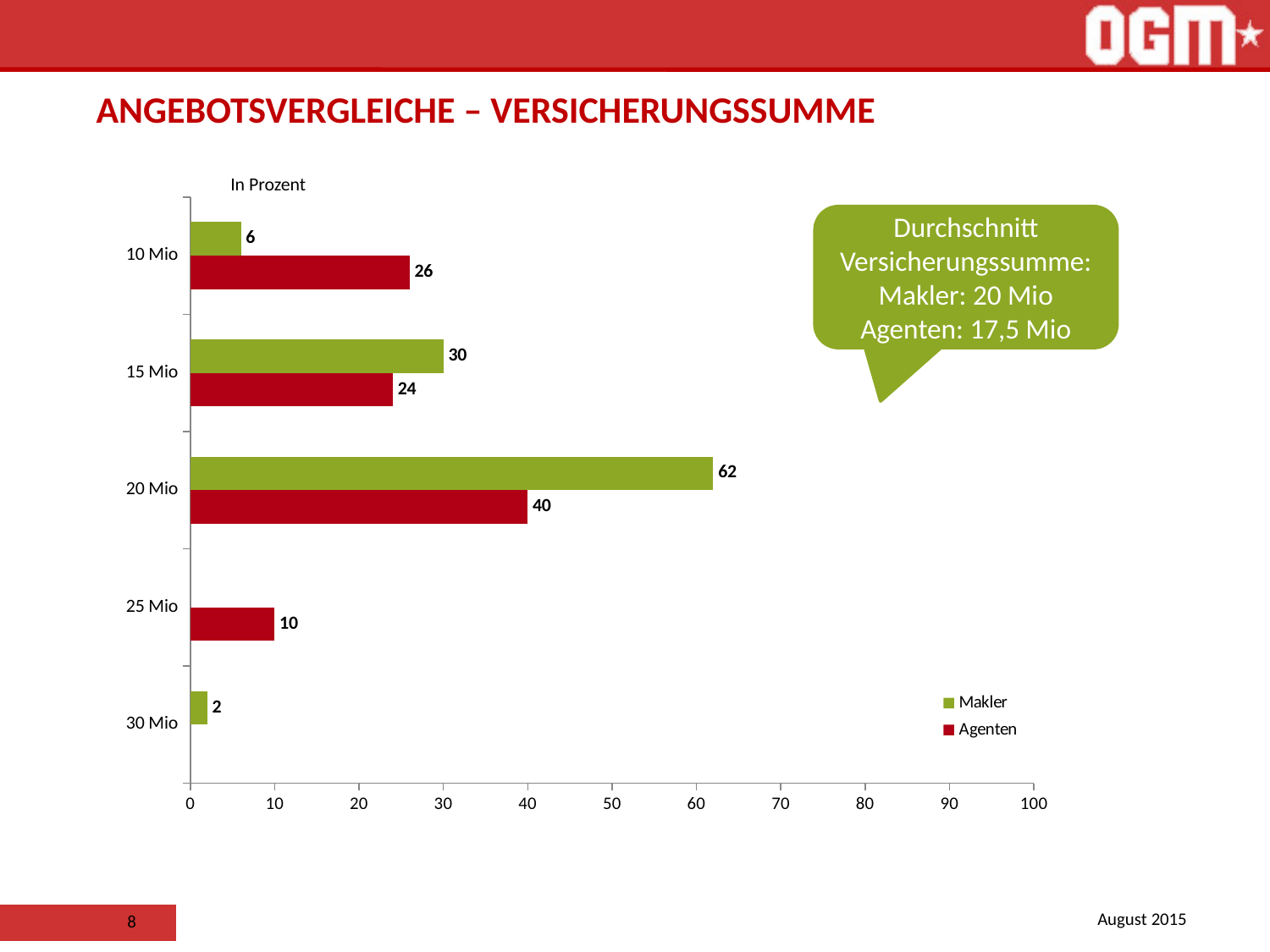
What is the Agenten value for 25 Mio? 10 How many series does the legend list? 2 What is the Makler value for 20 Mio? 62 Which category has the highest Makler value? 20 Mio What is the Makler value for 30 Mio? 2 What is the Agenten value for 10 Mio? 26 What is the difference between the Makler and Agenten values for 20 Mio? 22 How many categories are shown on the vertical axis? 5 What kind of chart is shown on the slide? Bar chart For 15 Mio, which series has the larger value, Makler or Agenten? Makler What unit label is shown above the chart? In Prozent